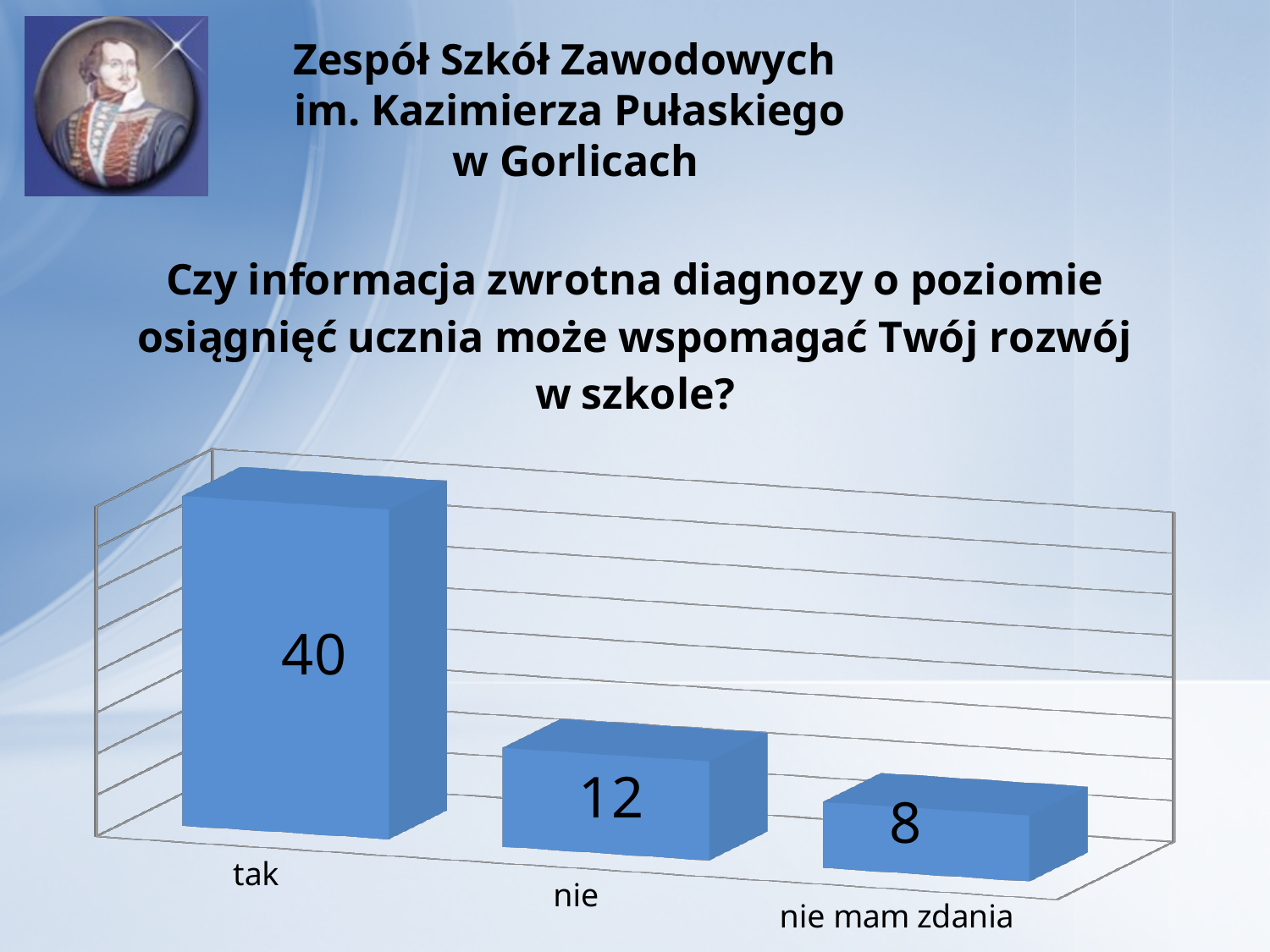
What kind of chart is shown on the slide? bar chart Which category has the highest value? tak What is the total of all three values shown in the chart? 60 What is the value for "nie"? 12 What is the difference between the values for "nie" and "nie mam zdania"? 4 Which category has the lowest value? nie mam zdania What is the difference between the values for "tak" and "nie"? 28 Which is larger, the value for "nie" or the value for "nie mam zdania"? nie What is the value for "nie mam zdania"? 8 How many categories are shown in the chart? 3 What is the value for "tak"? 40 Do the values rise or fall from left to right across the categories? fall